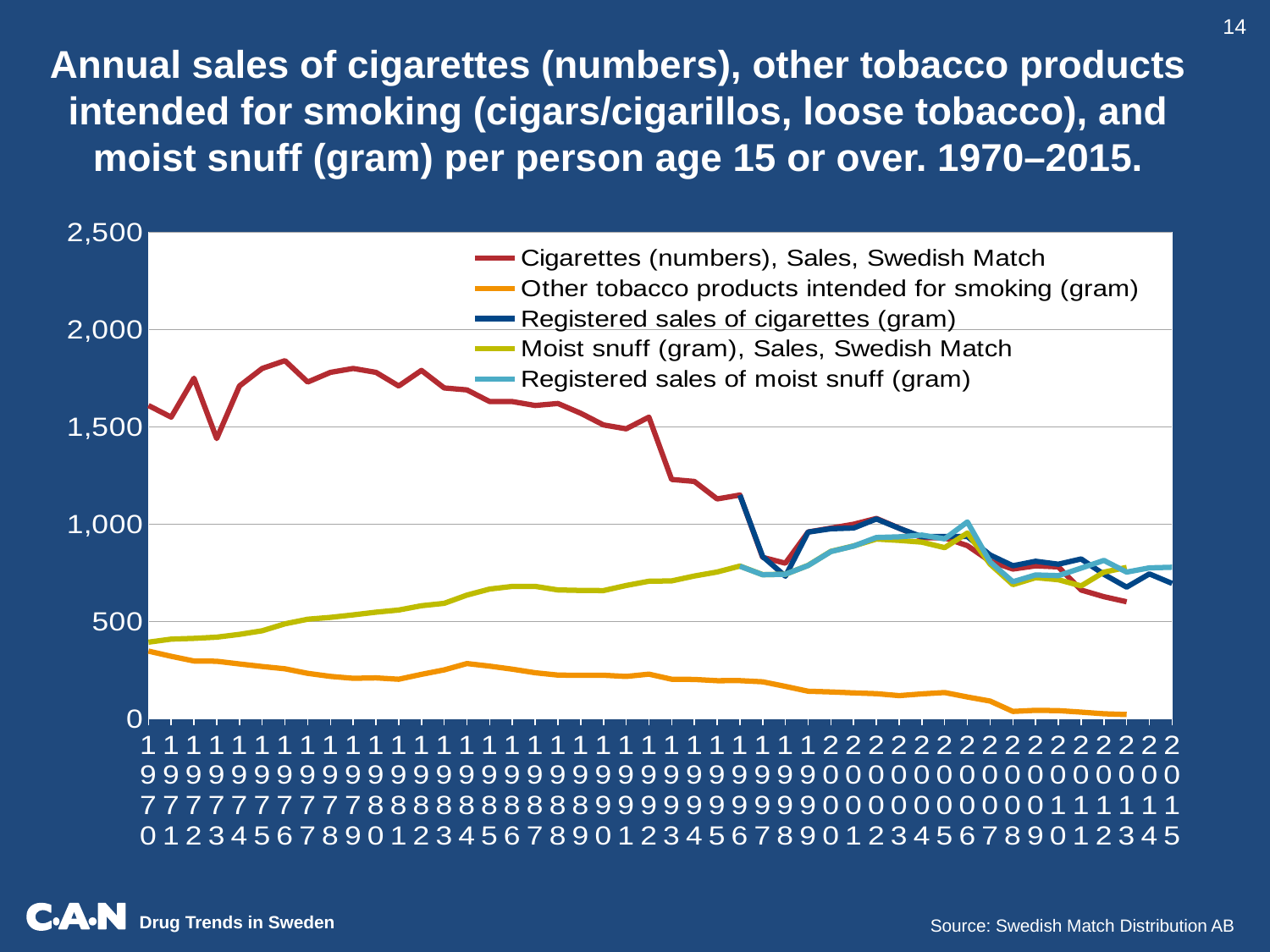
How many series does the legend list? 5 What kind of chart is shown on the slide? line chart Is the value for Cigarettes (numbers), Sales, Swedish Match in 1970 greater or less than 1,500? greater What colour is the line for Cigarettes (numbers), Sales, Swedish Match? red Is the value for Registered sales of moist snuff (gram) in 2000 greater or less than 500? greater In 1980, which is larger: Cigarettes (numbers), Sales, Swedish Match or Moist snuff (gram), Sales, Swedish Match? Cigarettes (numbers), Sales, Swedish Match Does the Moist snuff (gram), Sales, Swedish Match series rise or fall overall from 1970 to 1996? rise Does the Cigarettes (numbers), Sales, Swedish Match series rise or fall overall from 1970 to 2015? fall Which series has the lowest value in 2015? Registered sales of cigarettes (gram) Is the value for Cigarettes (numbers), Sales, Swedish Match in 1995 greater or less than 1,500? less